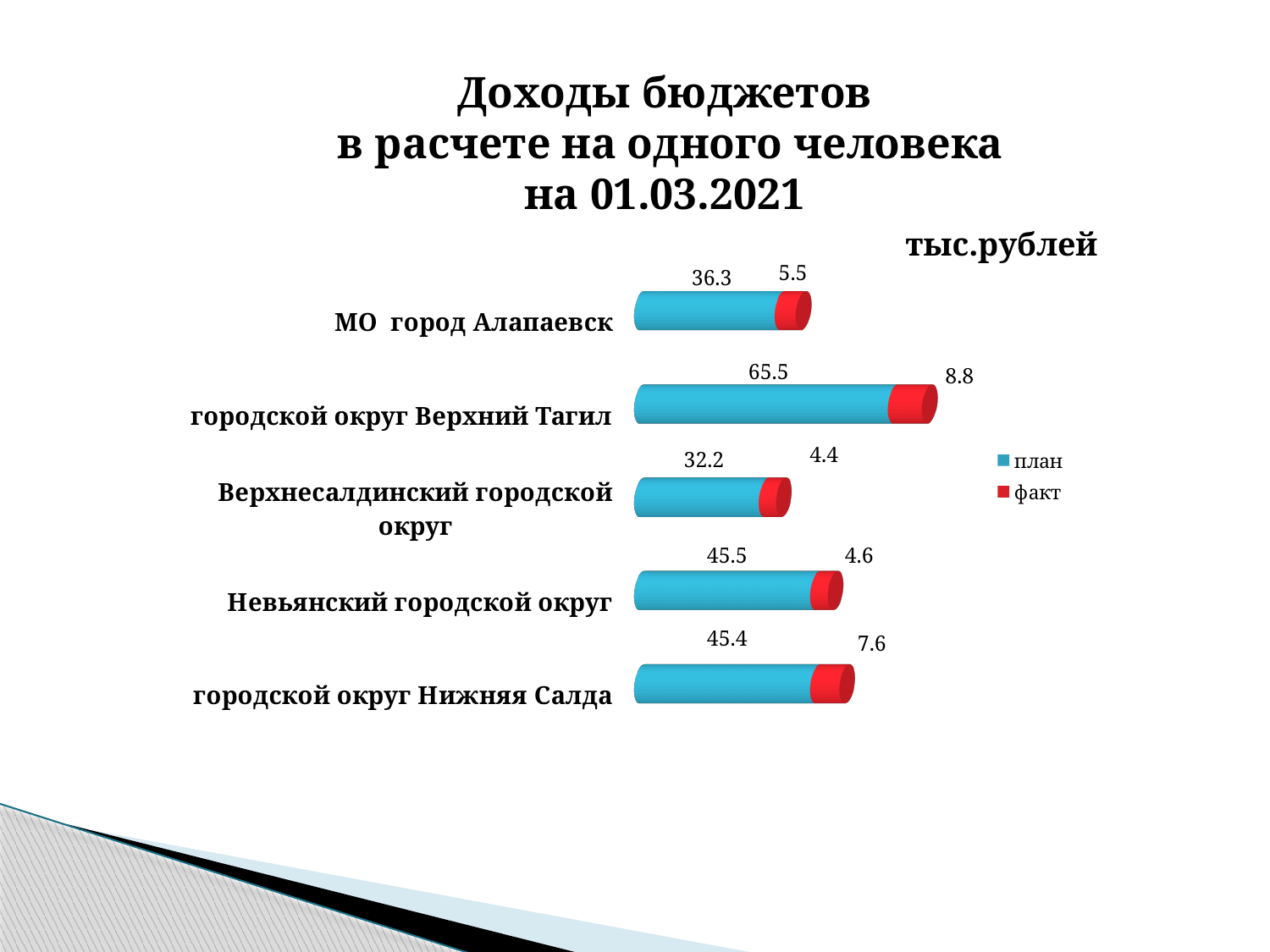
What is the план value for городской округ Верхний Тагил? 65.5 Which category has the lowest факт value? Верхнесалдинский городской округ What kind of chart is shown on the slide? bar chart Which is larger, the факт value for МО город Алапаевск or for Невьянский городской округ? МО город Алапаевск What is the difference between the план values for городской округ Верхний Тагил and МО город Алапаевск? 29.2 What is the план value for Верхнесалдинский городской округ? 32.2 Which category has the highest план value? городской округ Верхний Тагил How many series does the legend list? 2 What unit is stated above the chart? тыс.рублей What is the факт value for городской округ Нижняя Салда? 7.6 How many categories are shown on the chart? 5 What is the total of the stacked bar for Невьянский городской округ? 50.1